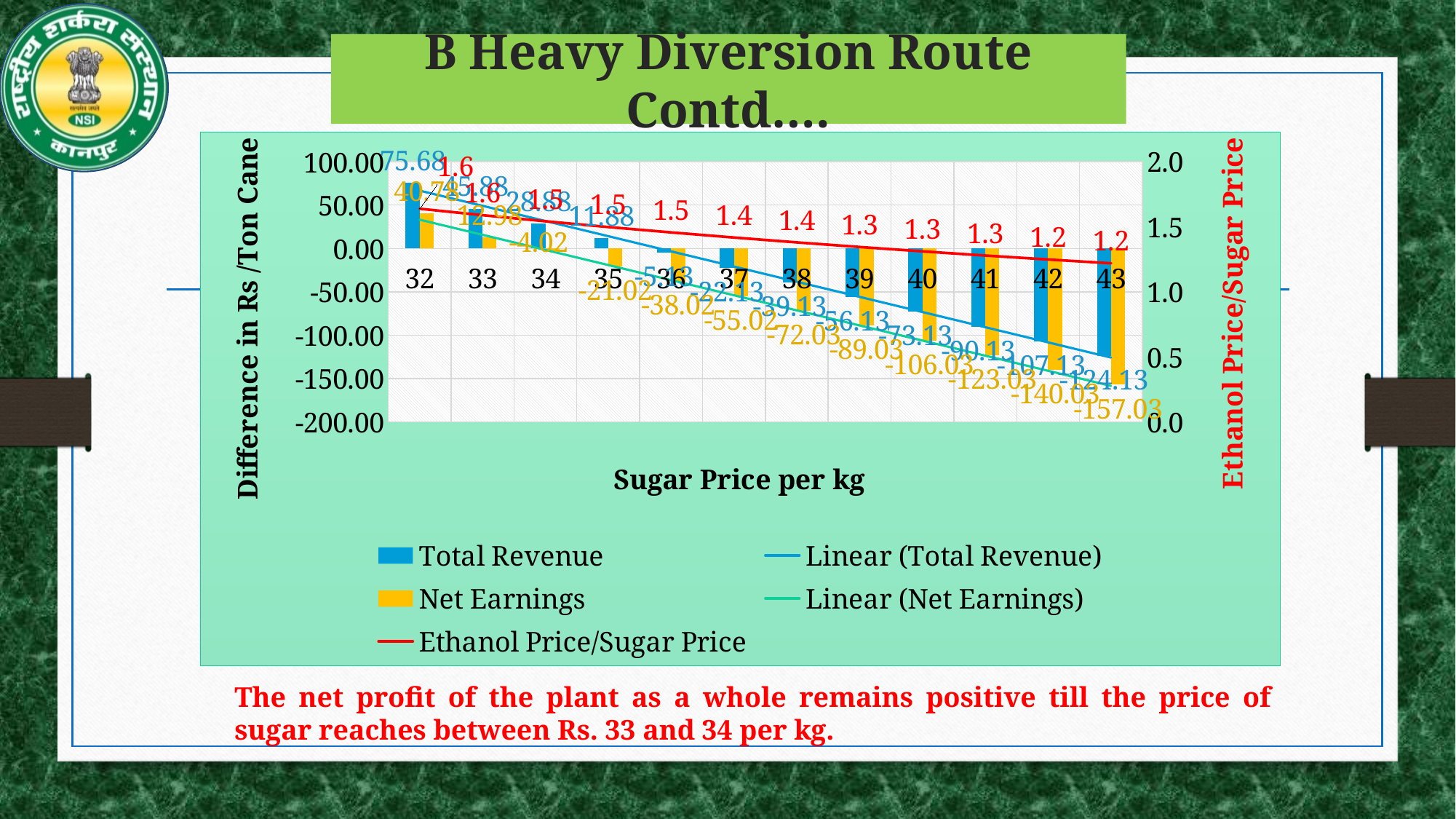
What is the Net Earnings value at a sugar price of 34? -4.02 Does the Ethanol Price/Sugar Price series rise or fall as the sugar price increases? fall What is the Net Earnings value at a sugar price of 43? -157.03 At which sugar price is Total Revenue highest? 32 What is the difference between Total Revenue and Net Earnings at a sugar price of 43? 32.90 What is the title of the x axis? Sugar Price per kg How many series does the legend list? 5 What is the Total Revenue value at a sugar price of 43? -124.13 At which sugar price is Net Earnings lowest? 43 How many sugar price categories are shown on the x axis? 12 What kind of chart is shown on the slide? combination bar and line chart What is the Ethanol Price/Sugar Price value at a sugar price of 32? 1.6